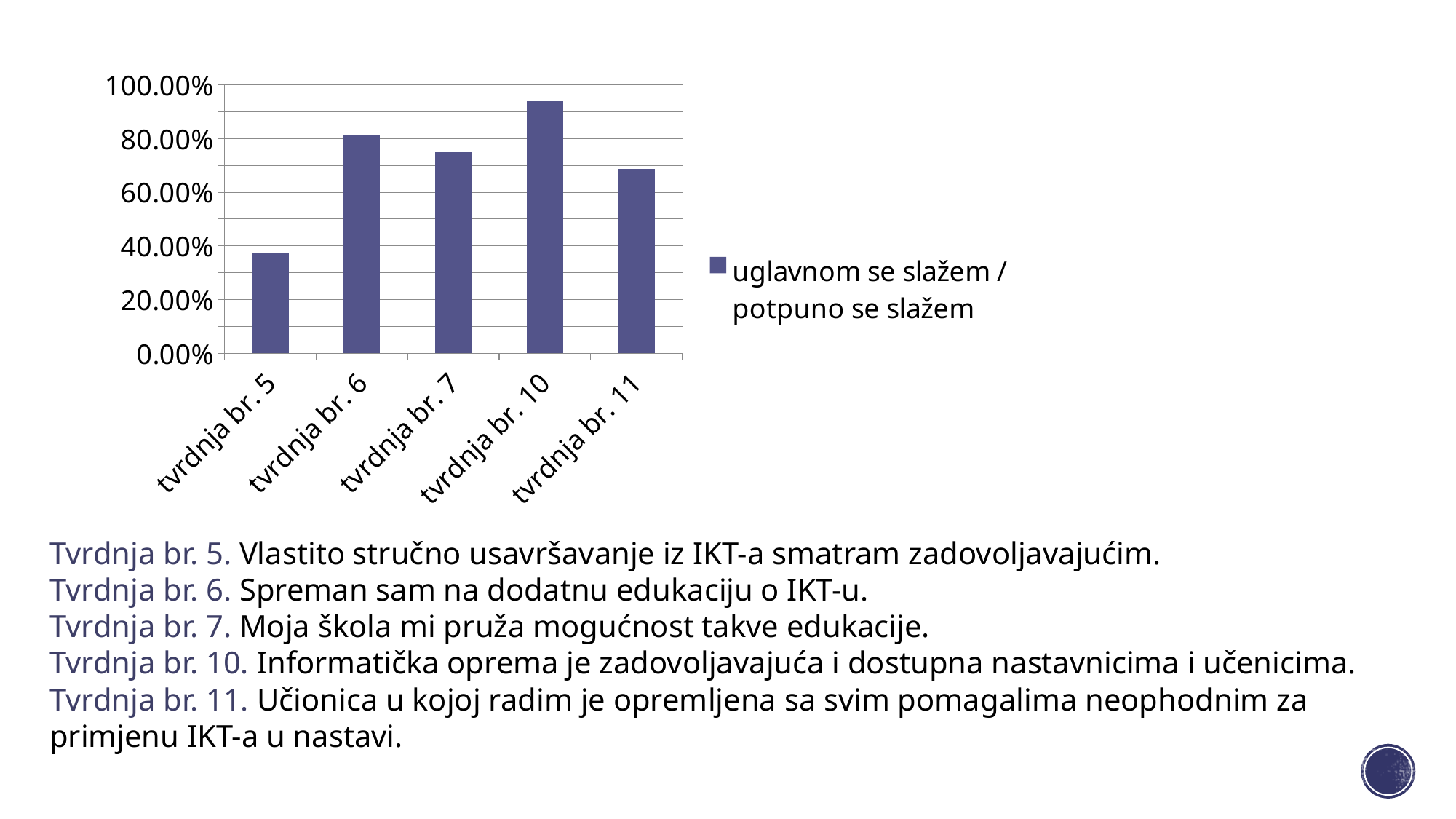
Which has the larger value, tvrdnja br. 11 or tvrdnja br. 5? tvrdnja br. 11 What is the legend entry for the series shown on the chart? uglavnom se slažem / potpuno se slažem How many categories (tvrdnje) are plotted on the chart? 5 Is the value for tvrdnja br. 5 greater or less than 40.00%? less Is the value for tvrdnja br. 7 greater or less than 80.00%? less Which category has the lowest value on the chart? tvrdnja br. 5 How many series does the chart legend list? 1 Which category has the highest value on the chart? tvrdnja br. 10 Is the value for tvrdnja br. 10 greater or less than 80.00%? greater Which has the larger value, tvrdnja br. 6 or tvrdnja br. 7? tvrdnja br. 6 What kind of chart is shown on the slide? bar chart